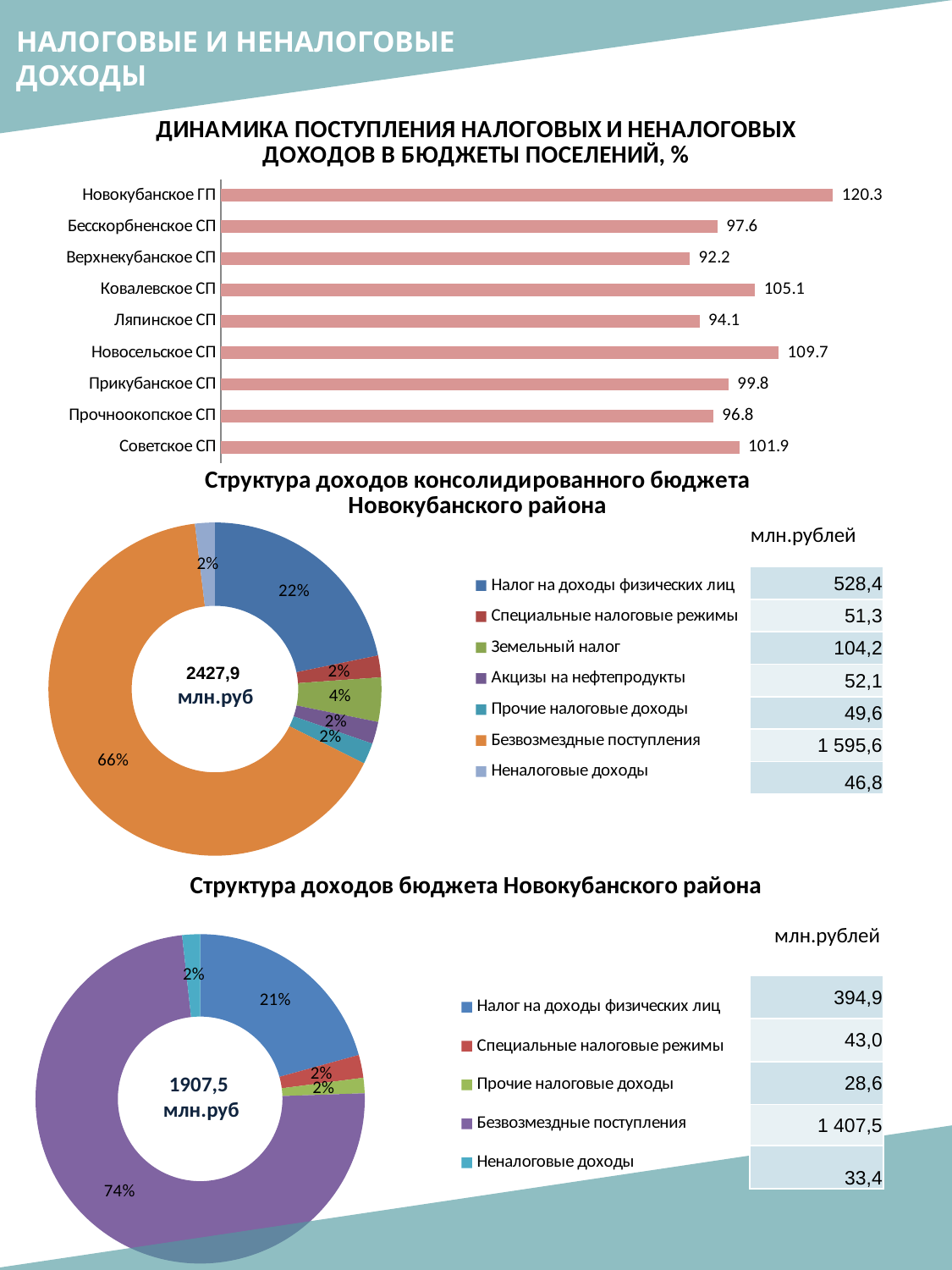
In the bar chart 'Динамика поступления налоговых и неналоговых доходов в бюджеты поселений, %', which settlement has the lowest value? Верхнекубанское СП In the bar chart 'Динамика поступления налоговых и неналоговых доходов в бюджеты поселений, %', which settlement has the highest value? Новокубанское ГП What type of chart is 'Динамика поступления налоговых и неналоговых доходов в бюджеты поселений, %'? Bar chart In the bar chart 'Динамика поступления налоговых и неналоговых доходов в бюджеты поселений, %', which is larger: Прикубанское СП or Прочноокопское СП? Прикубанское СП How many settlements are shown in the bar chart 'Динамика поступления налоговых и неналоговых доходов в бюджеты поселений, %'? 9 In the bar chart 'Динамика поступления налоговых и неналоговых доходов в бюджеты поселений, %', what is the value for Новокубанское ГП? 120.3 In the chart 'Структура доходов консолидированного бюджета Новокубанского района', what is the value in млн.рублей for Земельный налог? 104,2 In the chart 'Структура доходов бюджета Новокубанского района', what is the value in млн.рублей for Безвозмездные поступления? 1 407,5 In the chart 'Структура доходов консолидированного бюджета Новокубанского района', what share of the total is Безвозмездные поступления? 66% In the bar chart 'Динамика поступления налоговых и неналоговых доходов в бюджеты поселений, %', what is the value for Ляпинское СП? 94.1 In the bar chart 'Динамика поступления налоговых и неналоговых доходов в бюджеты поселений, %', what is the difference between Новосельское СП and Ковалевское СП? 4.6 How many categories does the legend list in the chart 'Структура доходов бюджета Новокубанского района'? 5